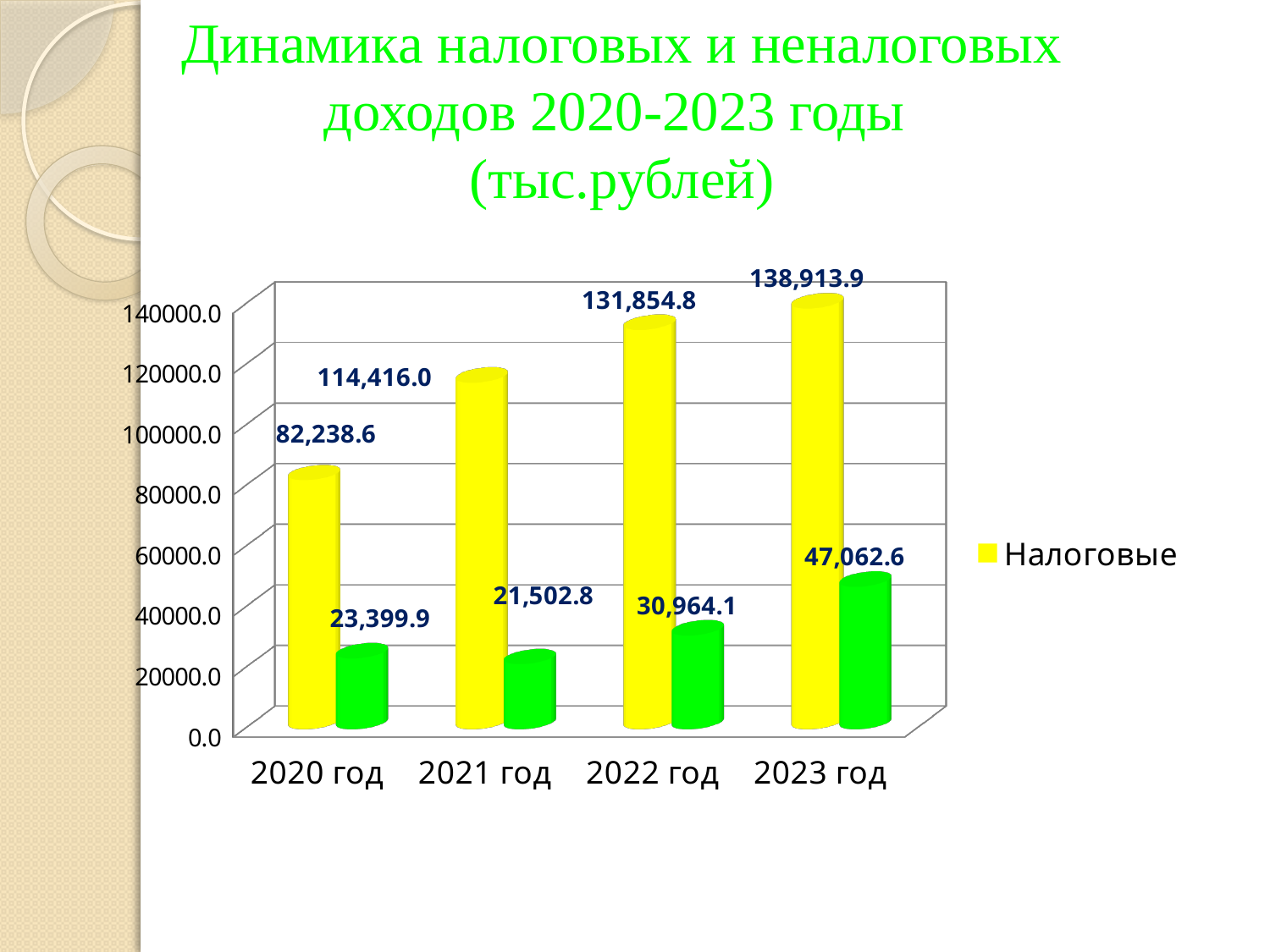
Do the Налоговые (yellow) values rise or fall from 2020 год to 2023 год? Rise How many years are shown on the x axis? 4 What is the value of the green bar for 2022 год? 30,964.1 What is the difference between the green bar values for 2023 год and 2022 год? 16,098.5 What is the value of the green bar for 2021 год? 21,502.8 What is the difference between the Налоговые values for 2023 год and 2022 год? 7,059.1 In which year is the green bar lowest? 2021 год In which year is the Налоговые (yellow) bar highest? 2023 год Which is larger: the Налоговые value for 2021 год or for 2020 год? 2021 год What is the value of the Налоговые (yellow) bar for 2020 год? 82,238.6 What is the value of the Налоговые (yellow) bar for 2023 год? 138,913.9 What kind of chart is shown on the slide? Bar chart